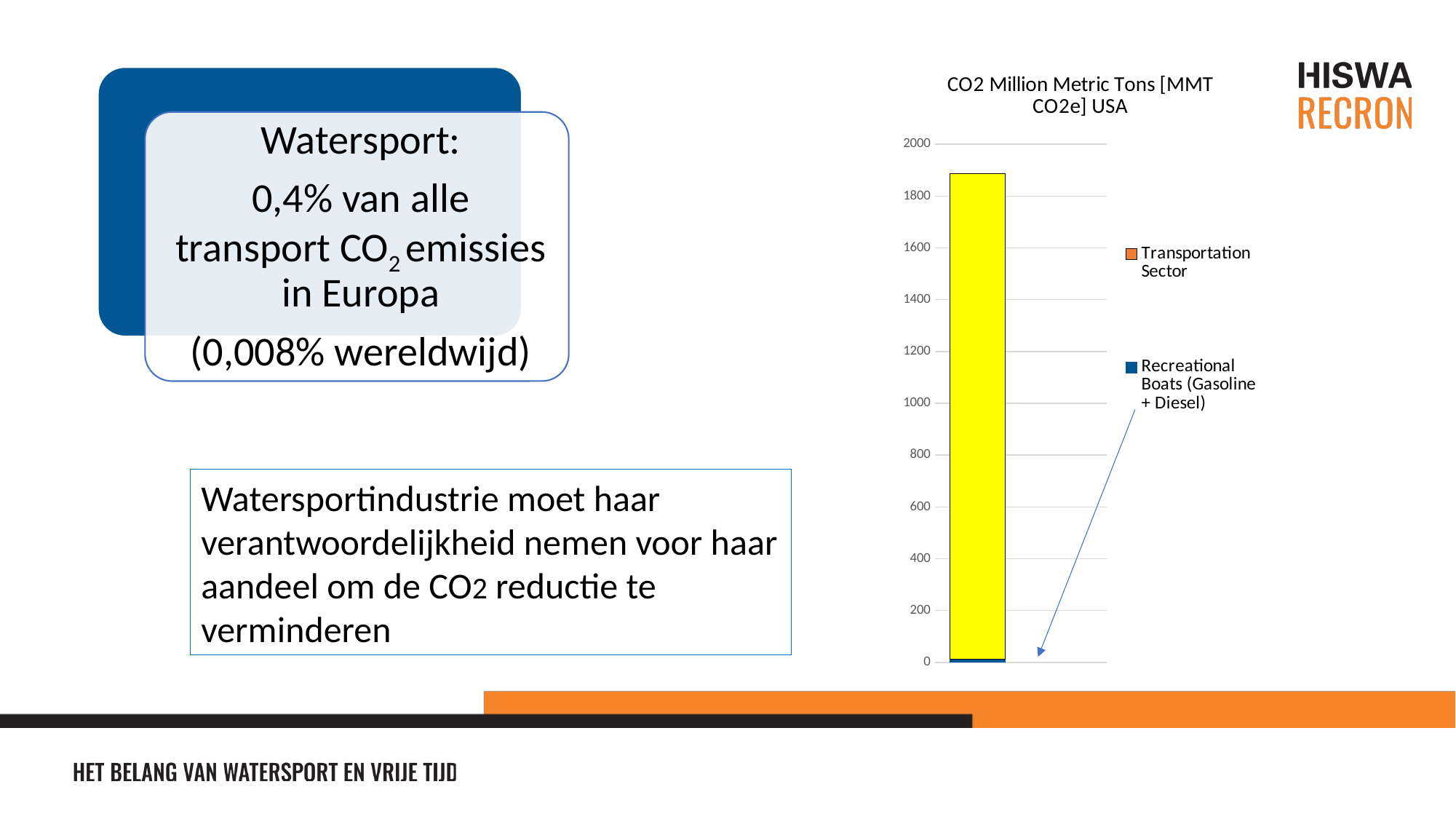
How many series does the chart legend list? 2 Is the value for Recreational Boats (Gasoline + Diesel) greater or less than 200? less How many bars are plotted in the chart? 1 What kind of chart is shown on the slide? Stacked bar chart Which series is larger, Transportation Sector or Recreational Boats (Gasoline + Diesel)? Transportation Sector Is the value for Transportation Sector greater or less than 1800? greater Which two series are listed in the chart legend? Transportation Sector; Recreational Boats (Gasoline + Diesel) What is the title of the chart? CO2 Million Metric Tons [MMT CO2e] USA What is the highest value shown on the chart's vertical axis? 2000 Is the total height of the stacked bar greater or less than 1600? greater Which series has the smallest value in the chart? Recreational Boats (Gasoline + Diesel)